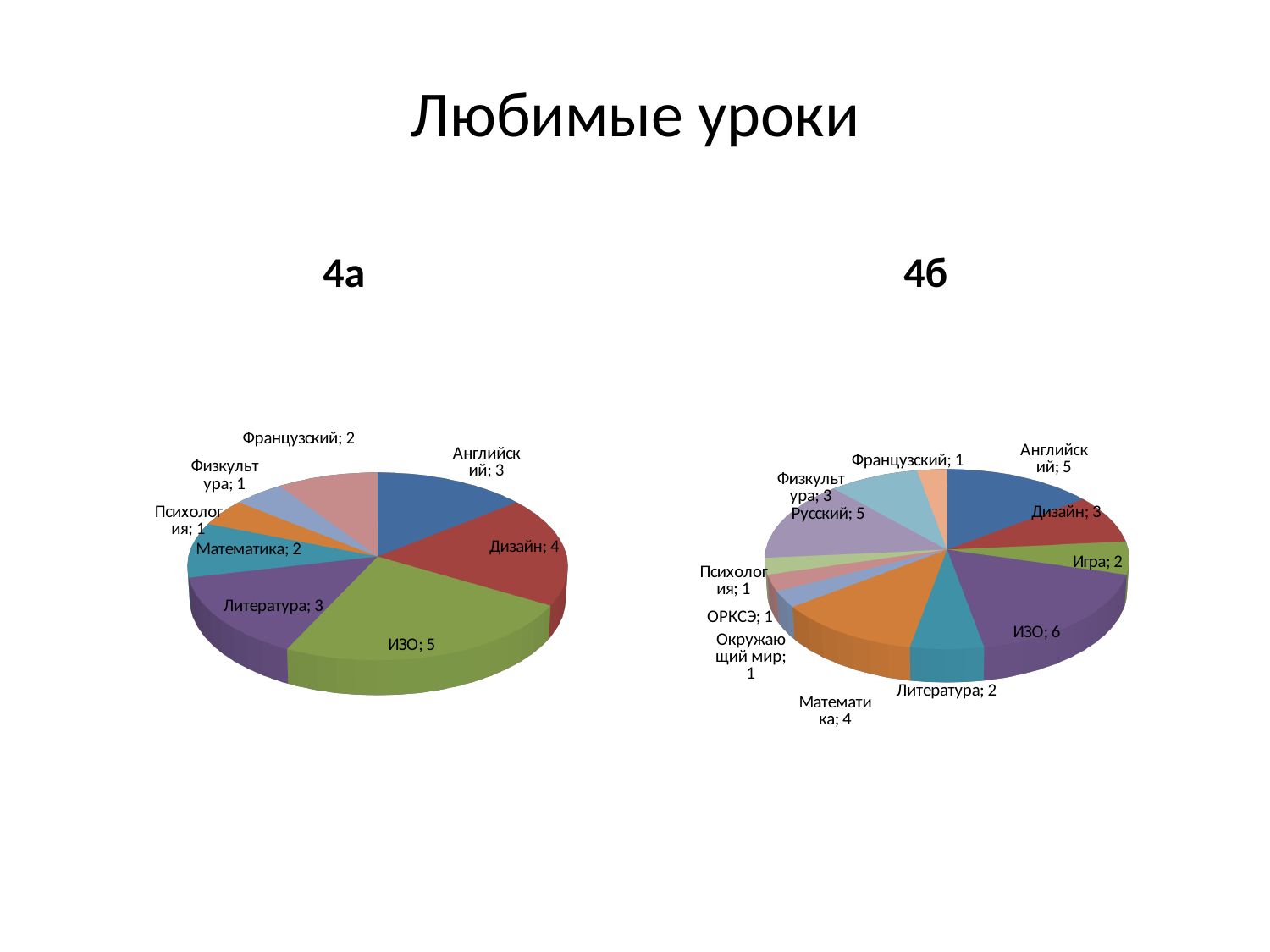
In the 4б chart, what is the value for Русский? 5 In the 4а chart, which subject has the largest slice? ИЗО In the 4б chart, what is the difference between the values for ИЗО and Литература? 4 What type of chart is used for 4а? Pie chart In the 4б chart, what is the value for Математика? 4 In the 4а chart, what is the difference between the values for ИЗО and Дизайн? 1 In the 4б chart, which is larger, Английский or Дизайн? Английский In the 4б chart, which subject has the largest slice? ИЗО How many categories does the 4а chart have? 8 In the 4а chart, how many students chose ИЗО? 5 What is the title of the slide? Любимые уроки How many categories does the 4б chart have? 12